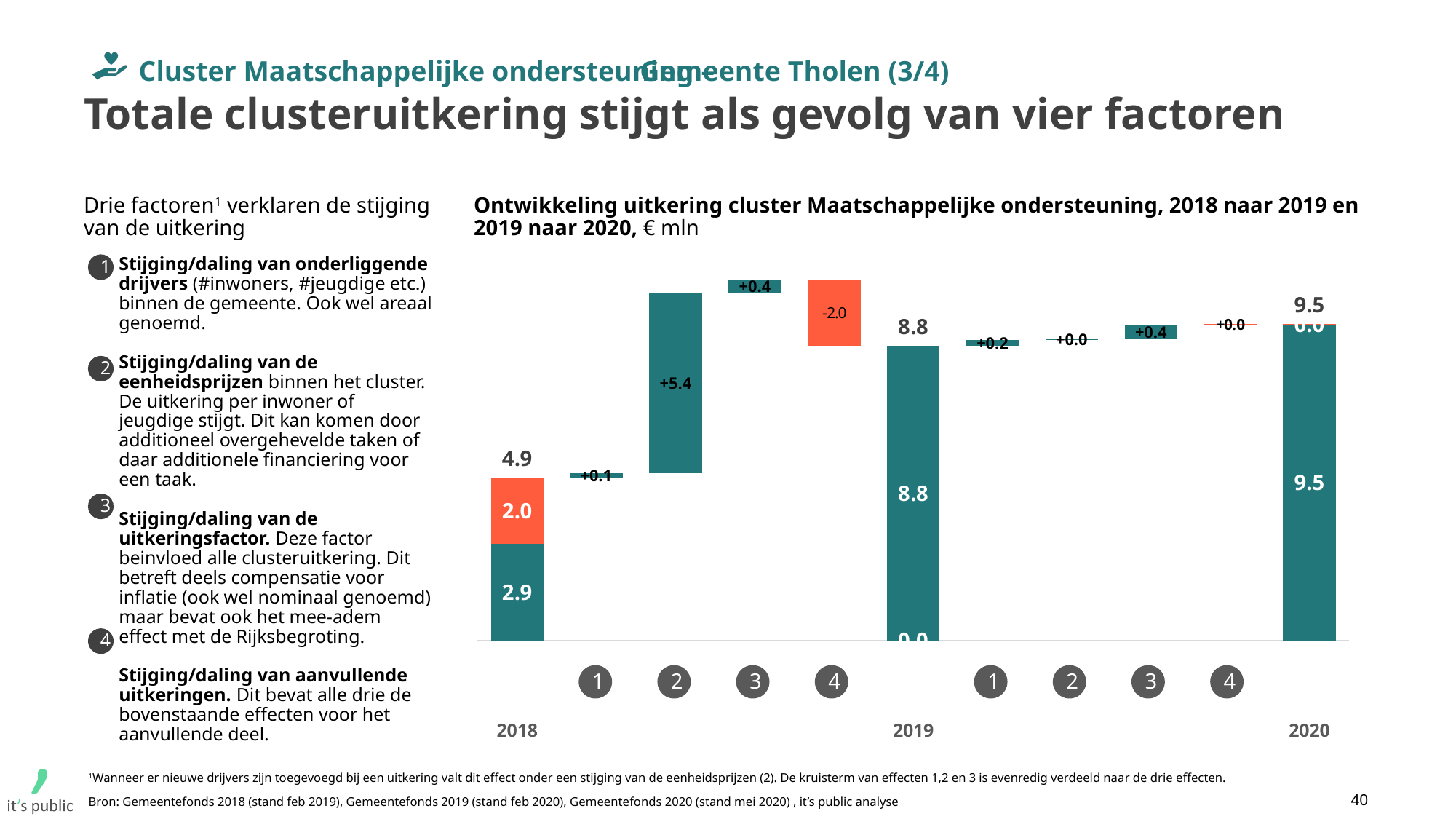
What is the total value shown for 2020 in the chart? 9.5 What is the value of step 3 (uitkeringsfactor) between 2019 and 2020? +0.4 What unit is stated in the chart title? € mln What is the value of the orange segment in the 2018 bar? 2.0 Which year has the highest total value in the chart? 2020 What is the total value shown for 2019 in the chart? 8.8 What is the value of step 2 (eenheidsprijzen) between 2018 and 2019? +5.4 Which step between 2018 and 2019 has the largest positive value? Step 2 (+5.4) What is the difference between the 2020 total and the 2018 total? 4.6 What is the value of step 4 (aanvullende uitkeringen) between 2018 and 2019? -2.0 What is the value of the teal segment in the 2018 bar? 2.9 What is the total value shown for 2018 in the chart? 4.9